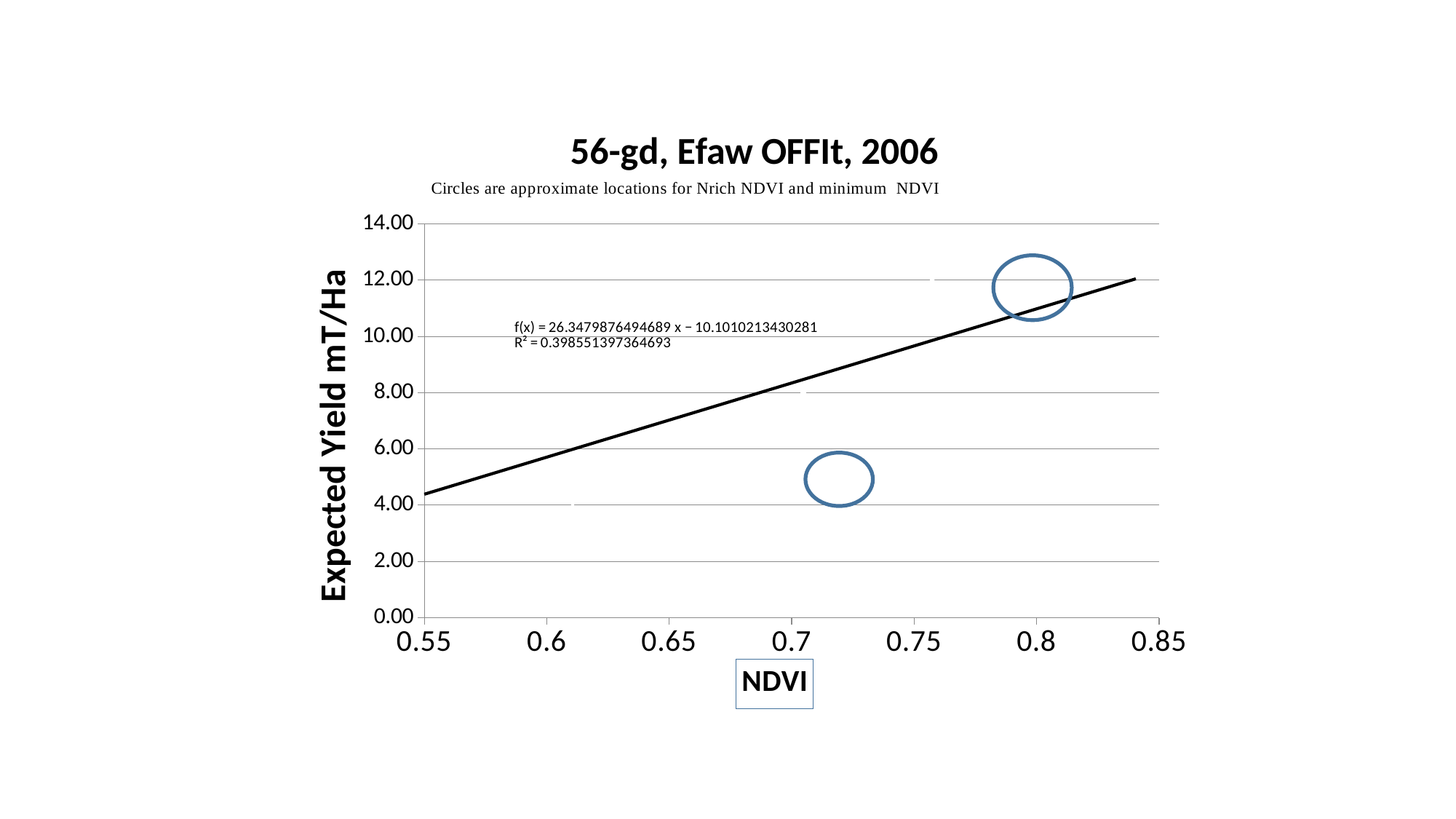
Does the trendline rise or fall as NDVI increases? rises Is the trendline value at NDVI 0.6 greater or less than 6.00? less What is the trendline equation printed on the chart? f(x) = 26.3479876494689 x − 10.1010213430281 Is the trendline value at NDVI 0.55 greater or less than 6.00? less What is the maximum value shown on the y axis? 14.00 Is the trendline value at NDVI 0.8 greater or less than 10.00? greater How many circles are drawn on the chart? 2 What is the label of the x axis? NDVI What is the R² value printed on the chart? 0.398551397364693 What is the title of the chart? 56-gd, Efaw OFFIt, 2006 What is the label of the y axis? Expected Yield mT/Ha What is the maximum value shown on the x axis? 0.85